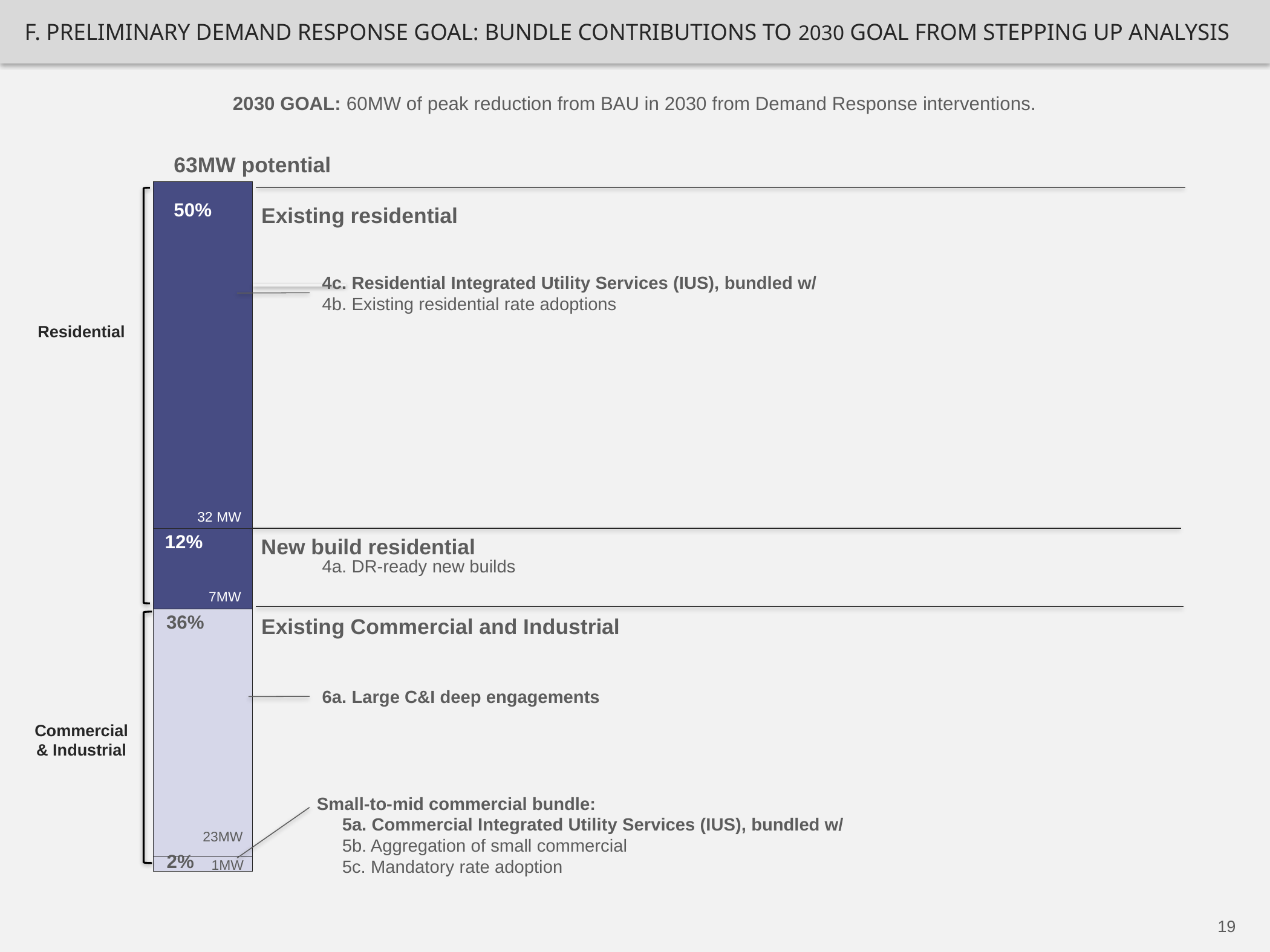
Which segment of the bar has the largest share? Existing residential How many MW does the Existing Commercial and Industrial segment contribute? 23MW What percentage share is shown for the smallest segment at the bottom of the bar? 2% Which is larger, the New build residential share or the Existing Commercial and Industrial share? Existing Commercial and Industrial What is the difference in MW between the Existing residential segment and the Existing Commercial and Industrial segment? 9 MW How many segments make up the stacked bar? 4 Which segment of the bar has the smallest share? Small-to-mid commercial bundle What percentage share of the bar does the Existing residential segment represent? 50% How many MW does the New build residential segment contribute? 7MW What is the total potential shown above the stacked bar? 63MW potential What kind of chart is shown on the slide? Stacked bar chart What are the two group labels shown to the left of the bar? Residential; Commercial & Industrial